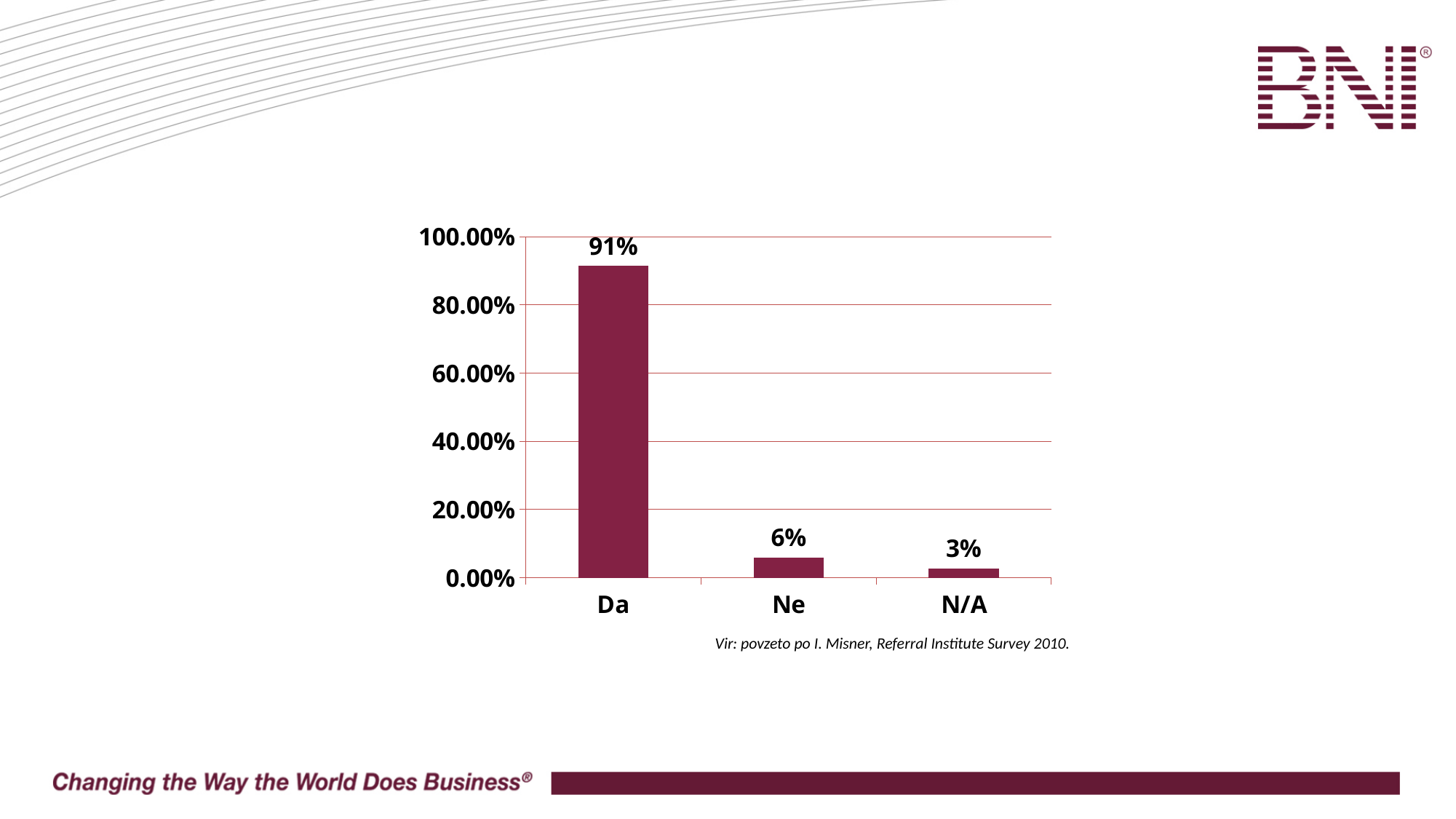
Which category has the lowest value? N/A Is the value for Da greater or less than 80.00%? greater Which is larger, the value for Ne or the value for N/A? Ne What kind of chart is shown on the slide? bar chart What is the difference between the values for Da and Ne? 85% What is the value for N/A? 3% What is the difference between the values for Ne and N/A? 3% What is the value for Da? 91% What is the highest value shown on the y axis? 100.00% Which category has the highest value? Da What is the value for Ne? 6% How many categories are shown on the x axis? 3